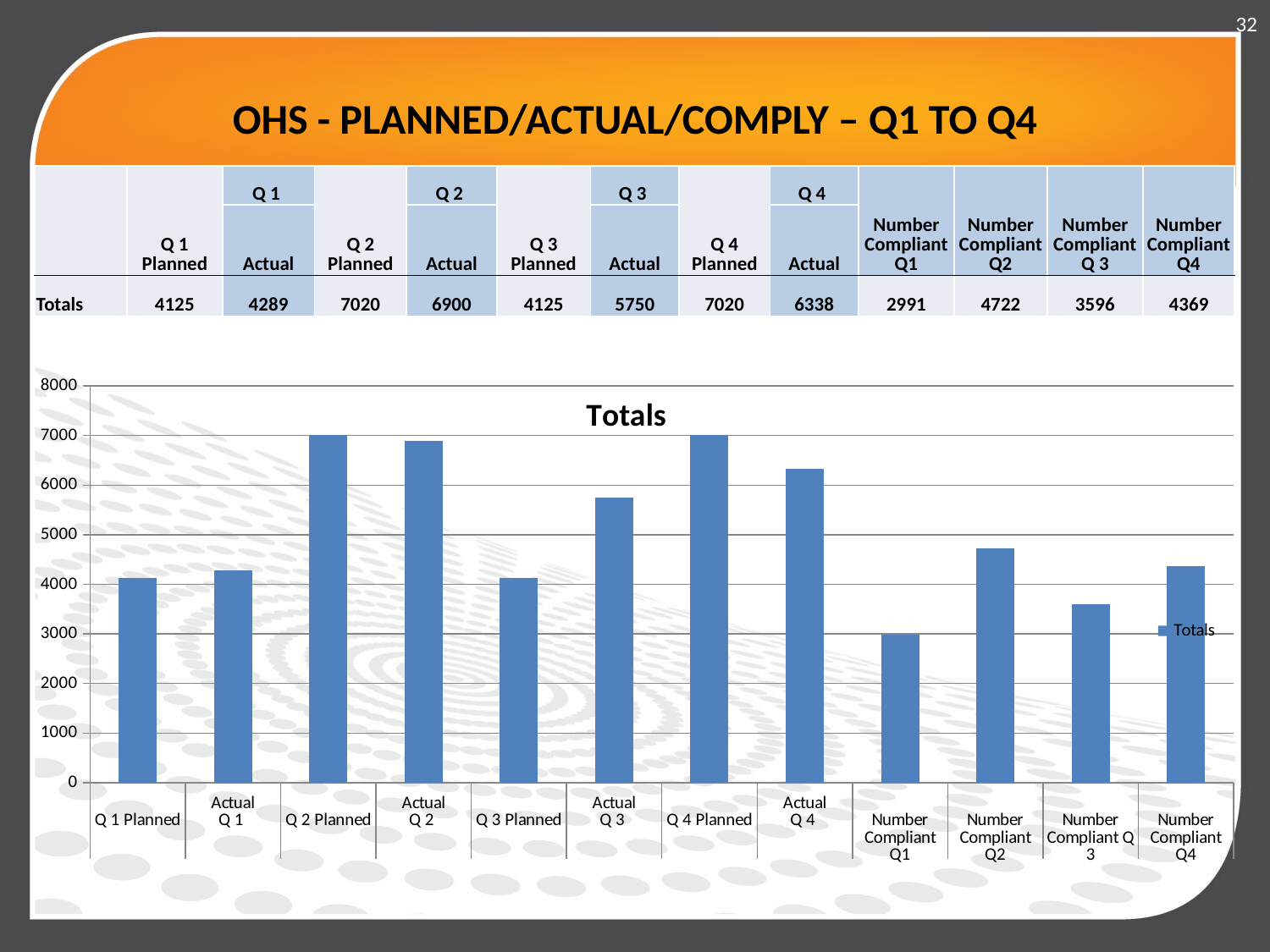
What is the value for Q 2 Planned? 7020 Which category has the lowest value? Number Compliant Q1 Is the value for Number Compliant Q 3 greater or less than 4000? less What is the value for Number Compliant Q1? 2991 Which is larger, Actual Q 3 or Q 3 Planned? Actual Q 3 What is the difference between Q 2 Planned and Actual Q 2? 120 How many series does the chart legend list? 1 What is the difference between Actual Q 1 and Q 1 Planned? 164 What kind of chart is shown on the slide? bar chart What is the title of the chart? Totals Is the value for Actual Q 4 greater or less than 6000? greater How many bars (categories) does the chart show? 12